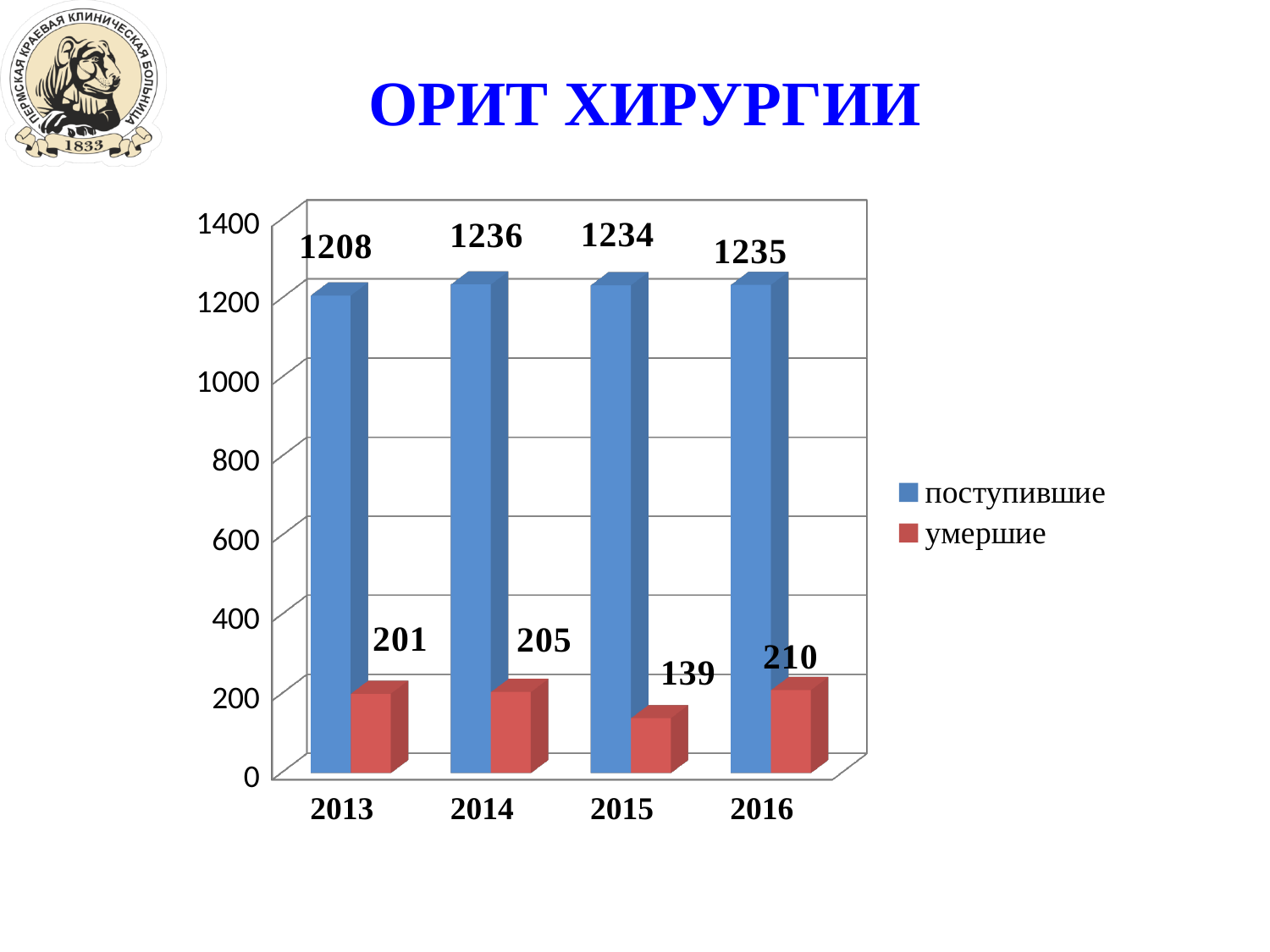
What is the value for умершие in 2016? 210 In which year is the value for умершие the lowest? 2015 What is the value for умершие in 2015? 139 In which year is the value for умершие the highest? 2016 In which year is the value for поступившие the lowest? 2013 What is the value for поступившие in 2013? 1208 Which is larger: умершие in 2013 or умершие in 2016? 2016 What is the difference between the умершие values for 2014 and 2015? 66 How many series does the legend list? 2 What is the value for поступившие in 2014? 1236 What is the difference between the поступившие values for 2016 and 2013? 27 What kind of chart is shown on the slide? Bar chart